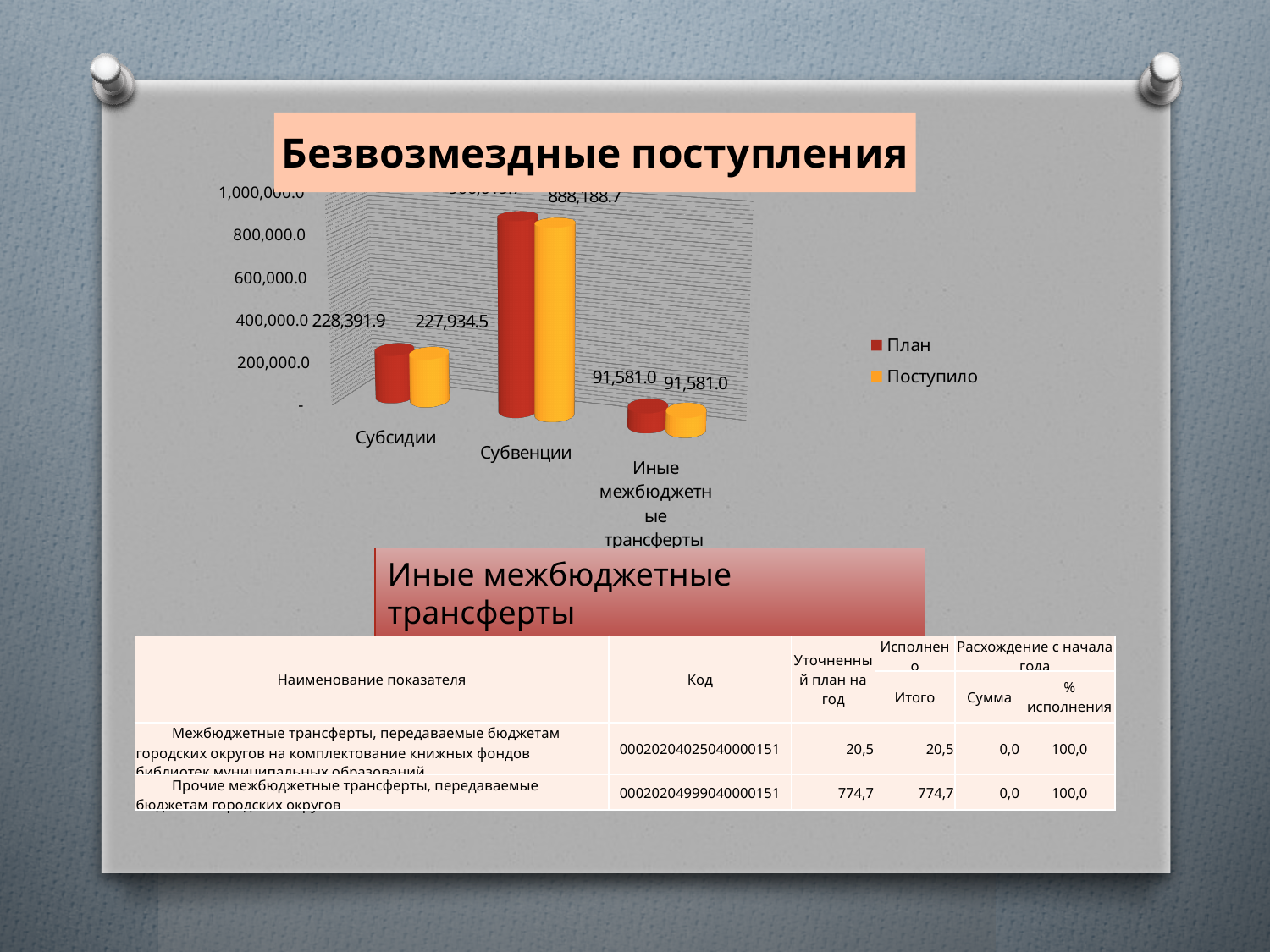
What is the План value for Иные межбюджетные трансферты? 91,581.0 How many series does the chart legend list? 2 What is the difference between the План and Поступило values for Субсидии? 457.4 Which category has the lowest Поступило value? Иные межбюджетные трансферты Is the План value for Субвенции greater or less than 800,000.0? greater Which is larger: the Поступило value for Субсидии or for Иные межбюджетные трансферты? Субсидии How many categories are shown on the x axis of the chart? 3 What is the Поступило value for Субвенции? 888,188.7 What type of chart is shown on the slide? bar chart Which category has the highest Поступило value? Субвенции What is the Поступило value for Субсидии? 227,934.5 What is the План value for Субсидии? 228,391.9